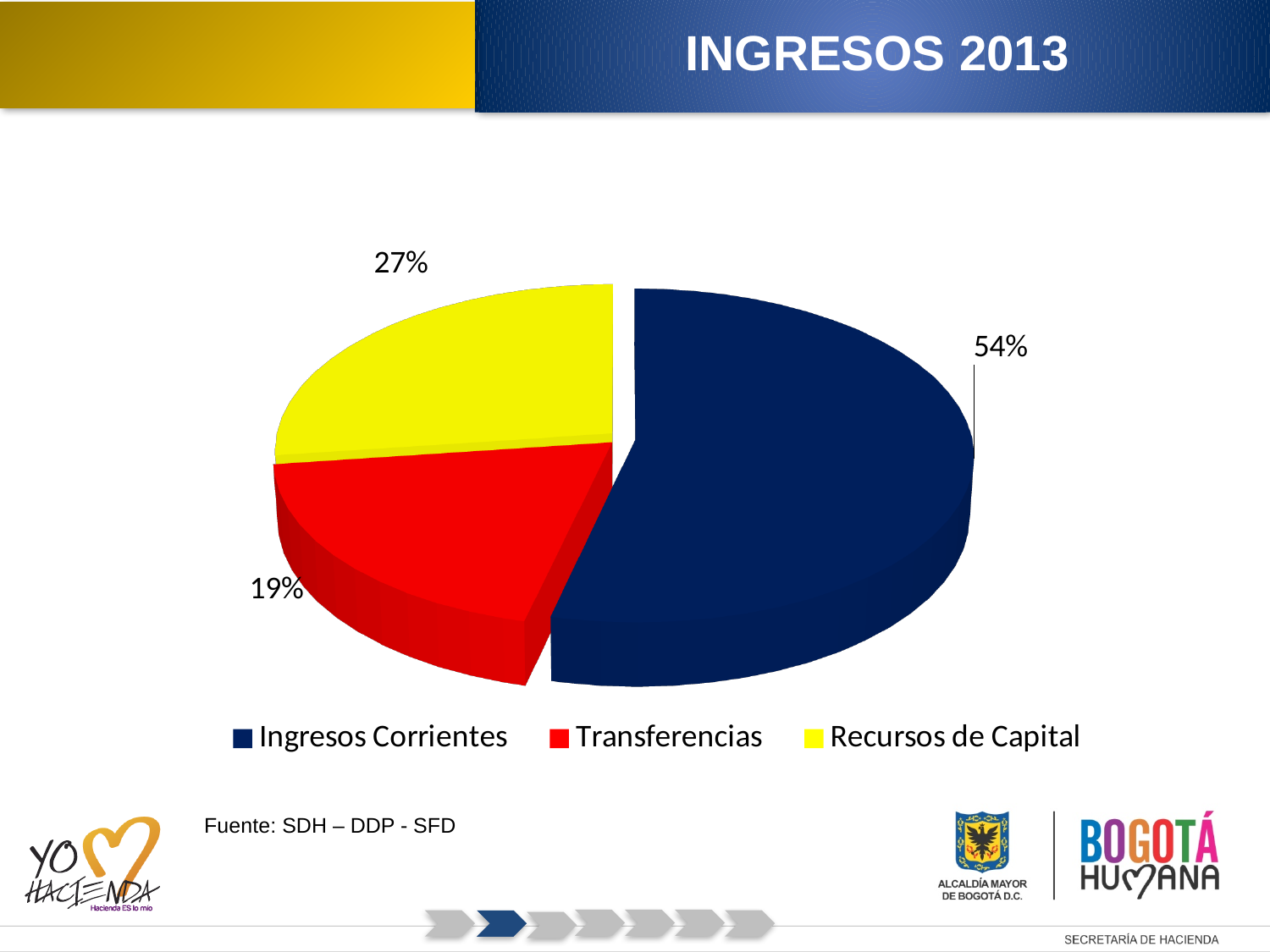
Which category has the largest slice of the pie? Ingresos Corrientes What share of the pie does Transferencias represent? 19% What share of the pie does Recursos de Capital represent? 27% What is the title of the slide? INGRESOS 2013 What is the difference in percentage points between Recursos de Capital and Transferencias? 8 What kind of chart is shown on the slide? Pie chart How many categories does the pie chart show? 3 What is the difference in percentage points between Ingresos Corrientes and Recursos de Capital? 27 What share of the pie does Ingresos Corrientes represent? 54% Which is larger, Transferencias or Recursos de Capital? Recursos de Capital Which category has the smallest slice of the pie? Transferencias What colour represents Transferencias in the legend? Red